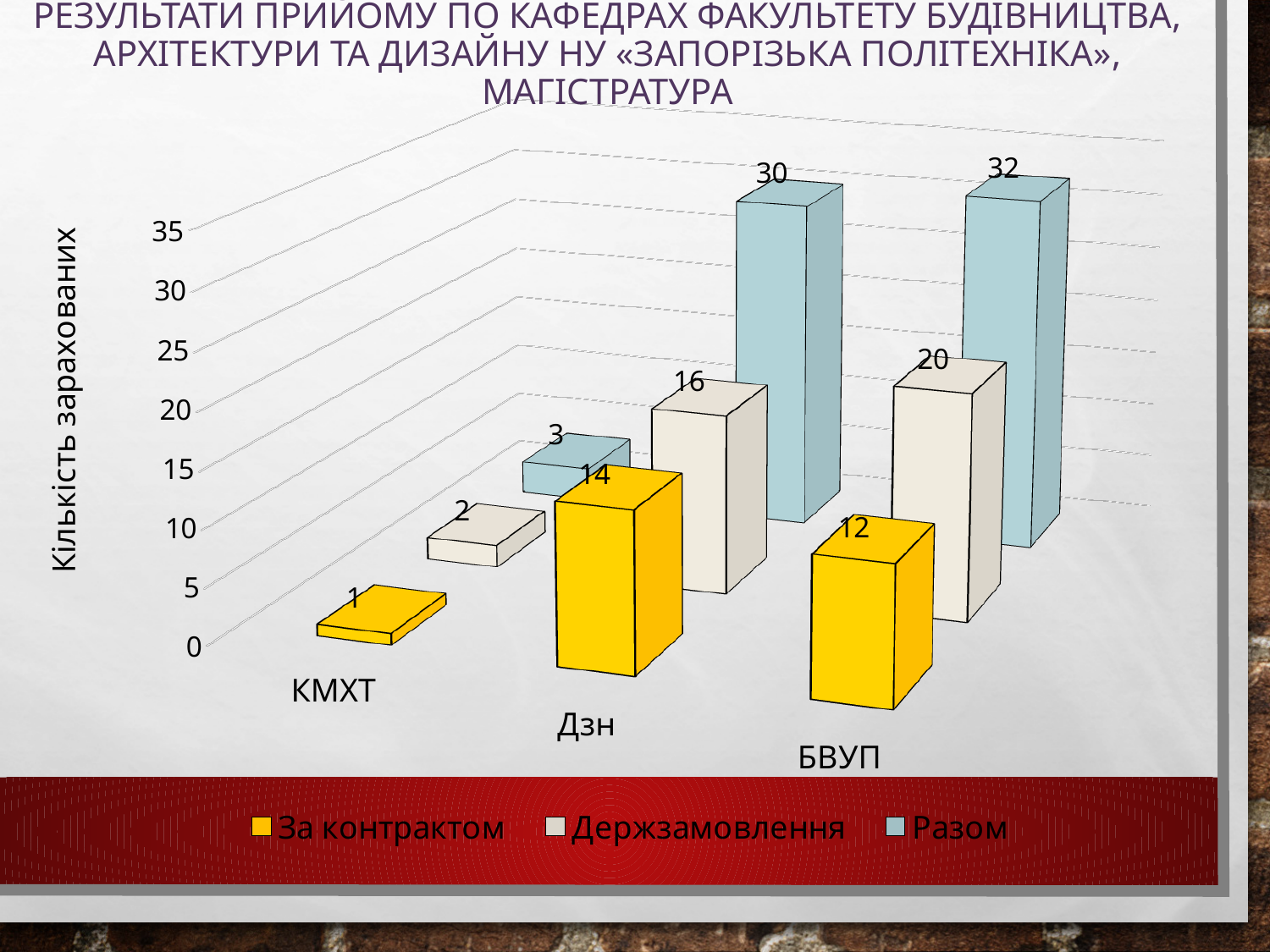
How many categories are shown on the x axis? 3 Which category has the lowest value in the За контрактом series? КМХТ Which is larger: the За контрактом value for Дзн or for БВУП? Дзн What is the value for БВУП in the Держзамовлення series? 20 Is the Держзамовлення value for Дзн greater or less than 10? greater What kind of chart is shown on the slide? bar chart How many series does the legend list? 3 Which category has the highest value in the Разом series? БВУП What is the label of the vertical axis? Кількість зарахованих What is the difference between the Разом values for БВУП and Дзн? 2 What is the value for КМХТ in the Разом series? 3 What is the value for Дзн in the За контрактом series? 14